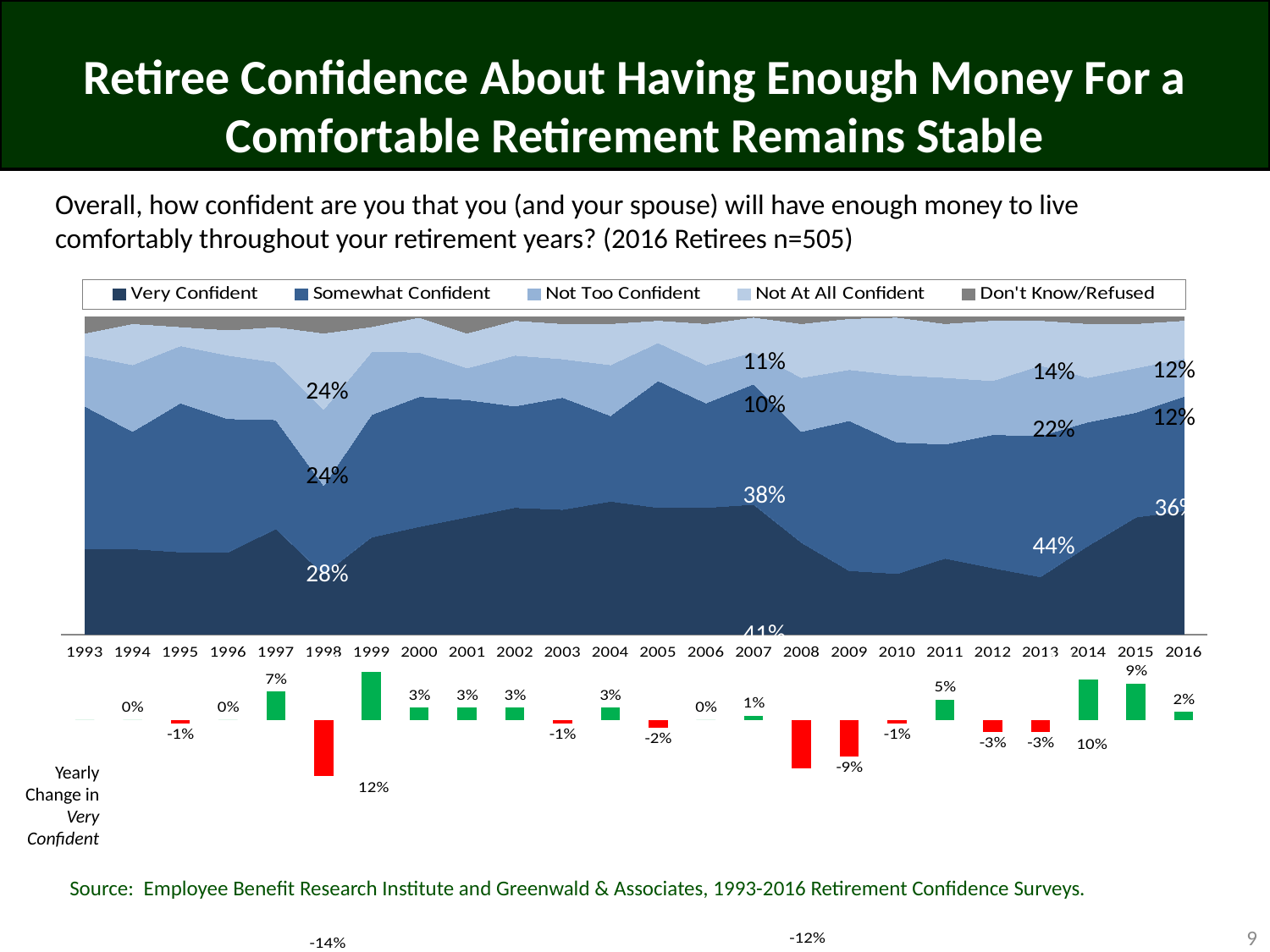
In the bottom 'Yearly Change in Very Confident' chart, what is the value for 2011? 5% How many series does the legend of the top chart list? 5 In the bottom 'Yearly Change in Very Confident' chart, what is the value for 1997? 7% In the bottom 'Yearly Change in Very Confident' chart, what is the value for 2016? 2% In the bottom 'Yearly Change in Very Confident' chart, which year has the larger value, 2011 or 2015? 2015 In the bottom 'Yearly Change in Very Confident' chart, what is the value for 2015? 9% In the bottom 'Yearly Change in Very Confident' chart, what is the difference between the 2015 value and the 2011 value? 4 percentage points In the bottom 'Yearly Change in Very Confident' chart, what colour are the bars for negative values? Red What kind of chart is the top chart on the slide? Stacked area chart In the bottom 'Yearly Change in Very Confident' chart, what is the value for 2009? -9% How many years are shown along the x axis of the top chart? 24 In the bottom 'Yearly Change in Very Confident' chart, what is the value for 2005? -2%